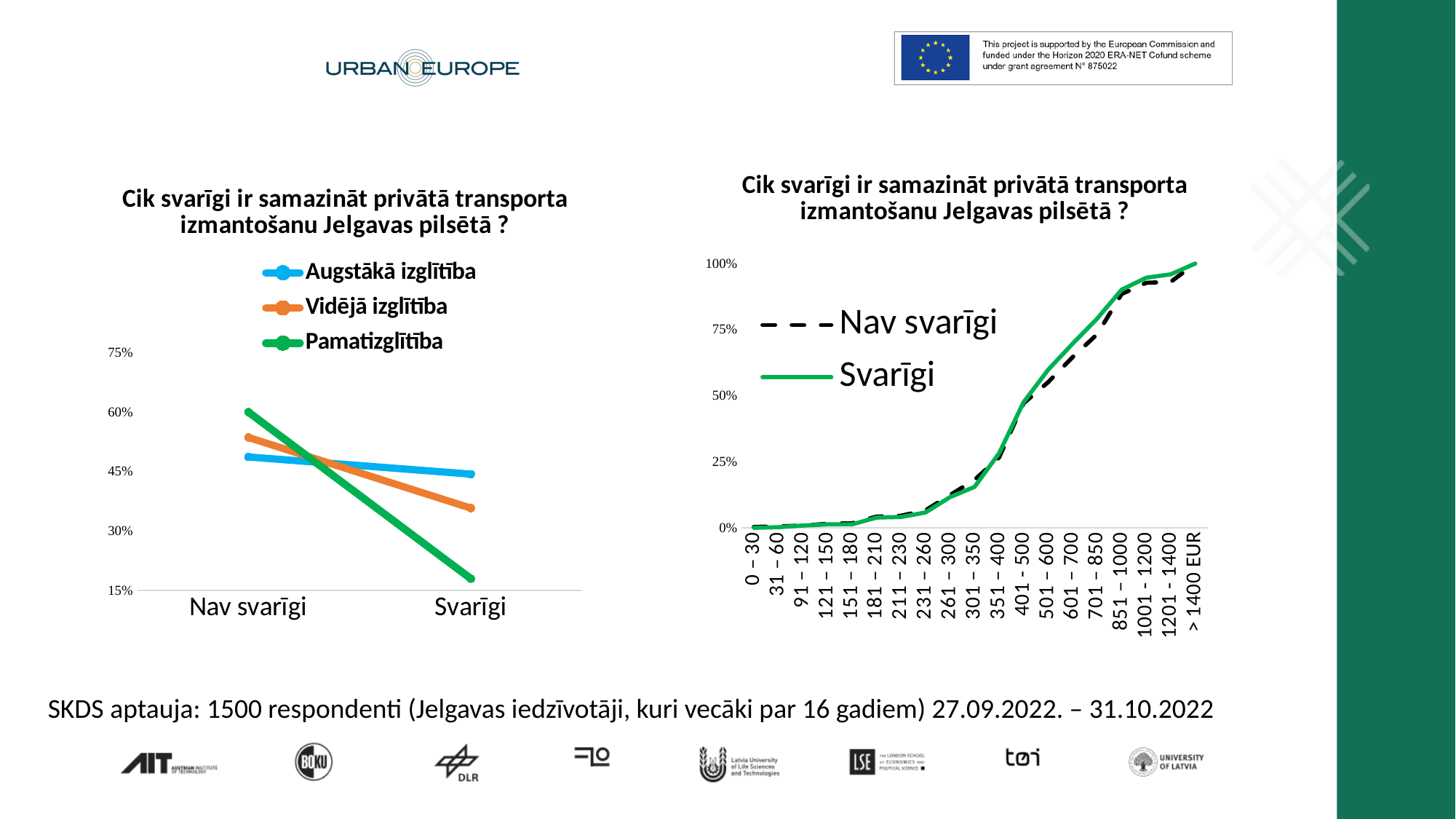
In the right chart, is the value for Svarīgi at '851 – 1000' greater or less than 75%? greater In the left chart, which series has the highest value at 'Nav svarīgi'? Pamatizglītība How many income categories are on the x axis of the right chart? 19 In the left chart, which is larger at 'Svarīgi': Augstākā izglītība or Vidējā izglītība? Augstākā izglītība How many series does the legend of the left chart list? 3 In the right chart, do the values rise or fall along the x axis from '0 – 30' to '> 1400 EUR'? rise How many series does the legend of the right chart list? 2 In the left chart, which series has the lowest value at 'Svarīgi'? Pamatizglītība In the left chart, is the value for Pamatizglītība at 'Svarīgi' greater or less than 30%? less What kind of chart is the left chart on the slide? line chart In the left chart, is the value for Augstākā izglītība at 'Nav svarīgi' greater or less than 45%? greater How many categories are on the x axis of the left chart? 2